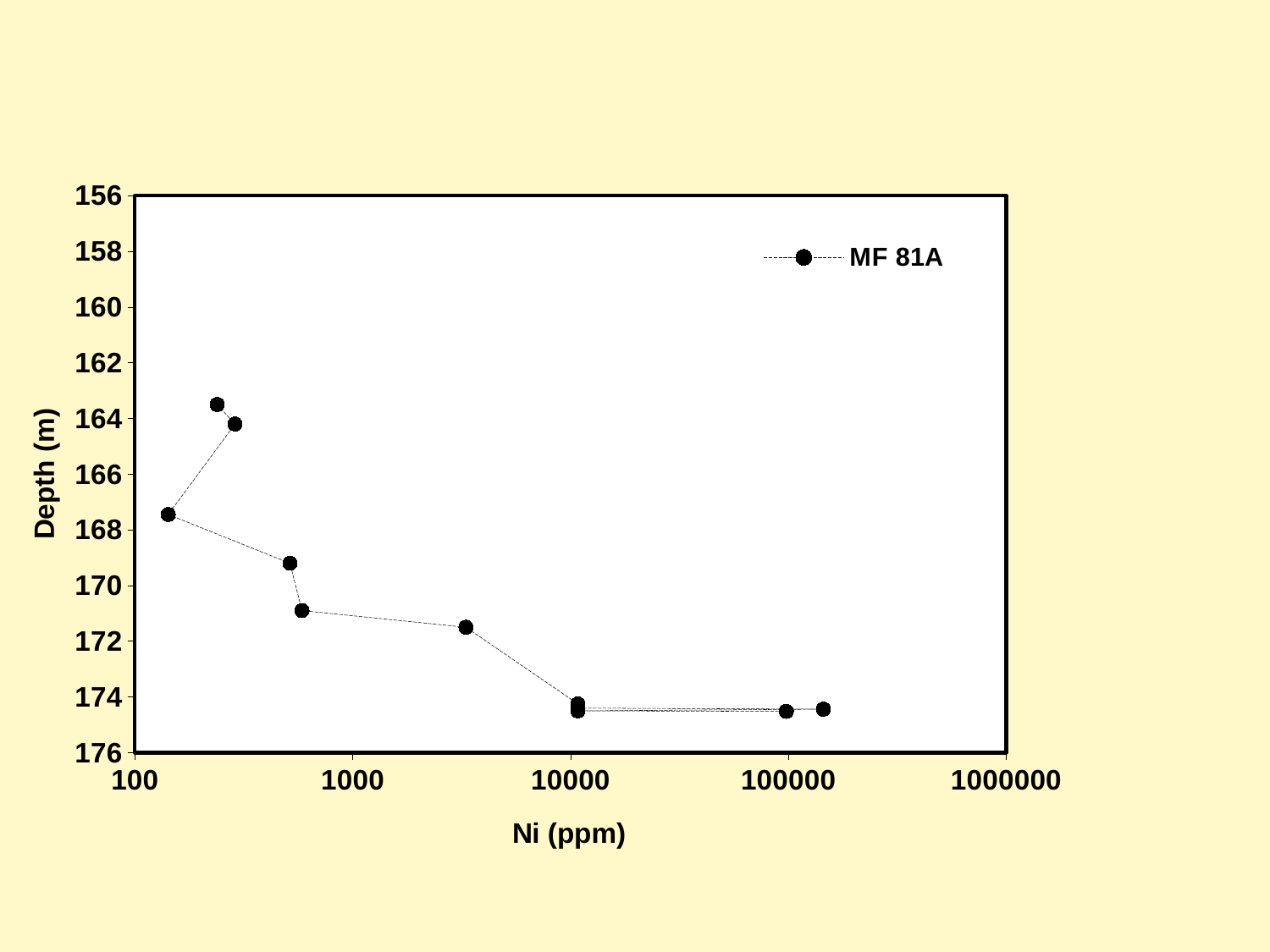
Is the Ni value of the point at about 171.5 m depth greater or less than 1000 ppm? greater Which has the higher Ni value: the point at about 167.5 m depth or the point at about 169 m depth? The point at about 169 m depth What is the name of the series shown in the legend? MF 81A Are the points with the highest Ni values found at the shallowest or the deepest depths? deepest Overall, does the Ni concentration increase or decrease as depth increases from about 167 m to about 174 m? increase Is the lowest Ni value plotted for MF 81A greater or less than 1000 ppm? less What kind of chart is shown on the slide? Scatter plot with connected points (line chart) Is the Ni value of the shallowest point (near 163.5 m depth) greater or less than 1000 ppm? less How many series does the legend list? 1 What is the title of the x axis? Ni (ppm)